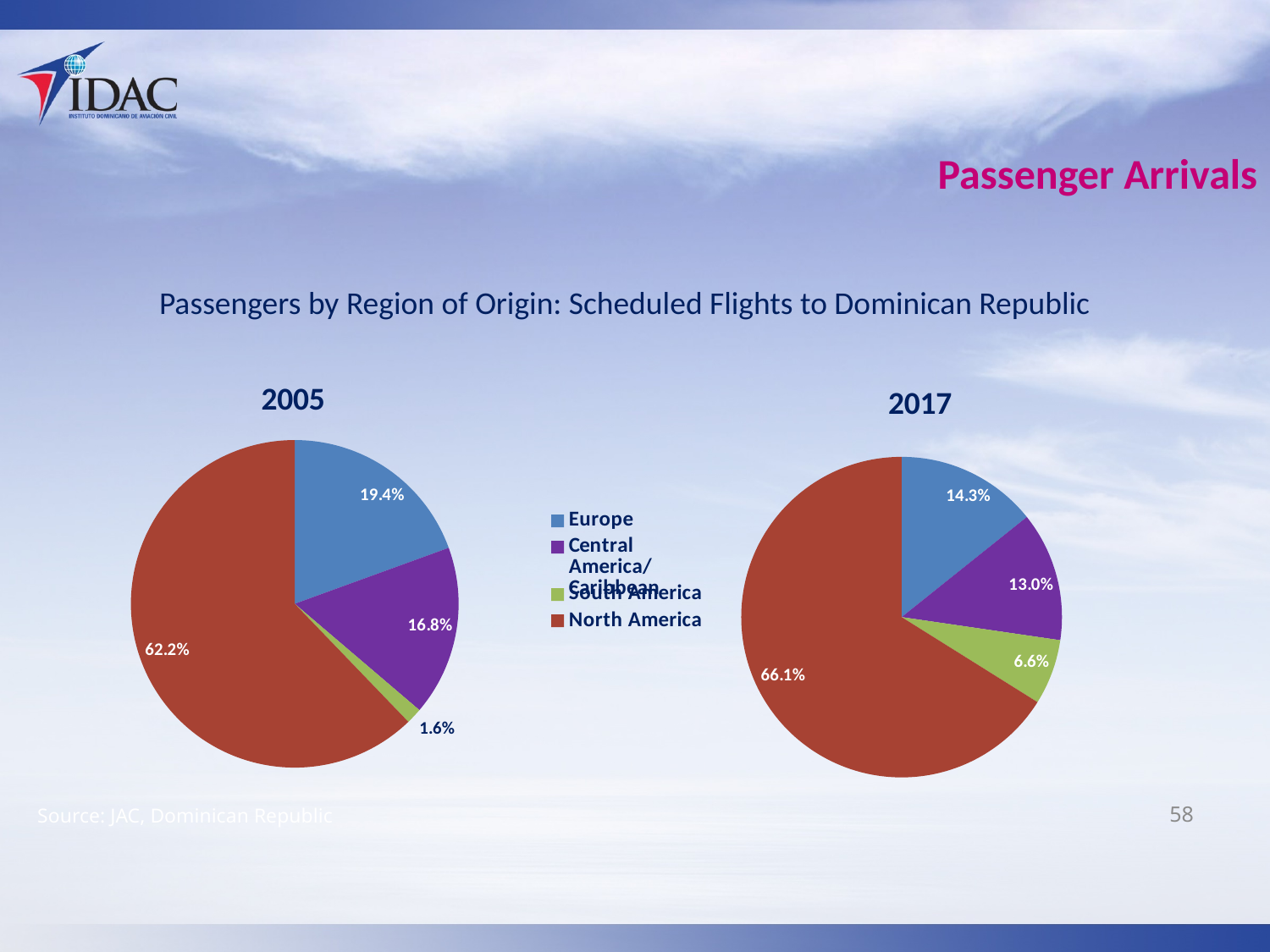
In the 2005 pie chart, what is the difference between the Europe share and the Central America/Caribbean share? 2.6% In the 2017 pie chart, what is the value for Central America/Caribbean? 13.0% What type of chart is used to show passengers by region of origin? Pie chart In the 2005 pie chart, what share of passengers came from North America? 62.2% How many regions are shown in each pie chart? 4 Which colour represents North America in the pie charts? Red In the 2005 pie chart, which region has the smallest share? South America What is the difference between the North America share in 2017 and in 2005? 3.9% In the 2005 pie chart, what is the value for South America? 1.6% Which is larger: the South America share in 2005 or in 2017? 2017 In the 2017 pie chart, which region has the largest share? North America In the 2017 pie chart, what share of passengers came from Europe? 14.3%